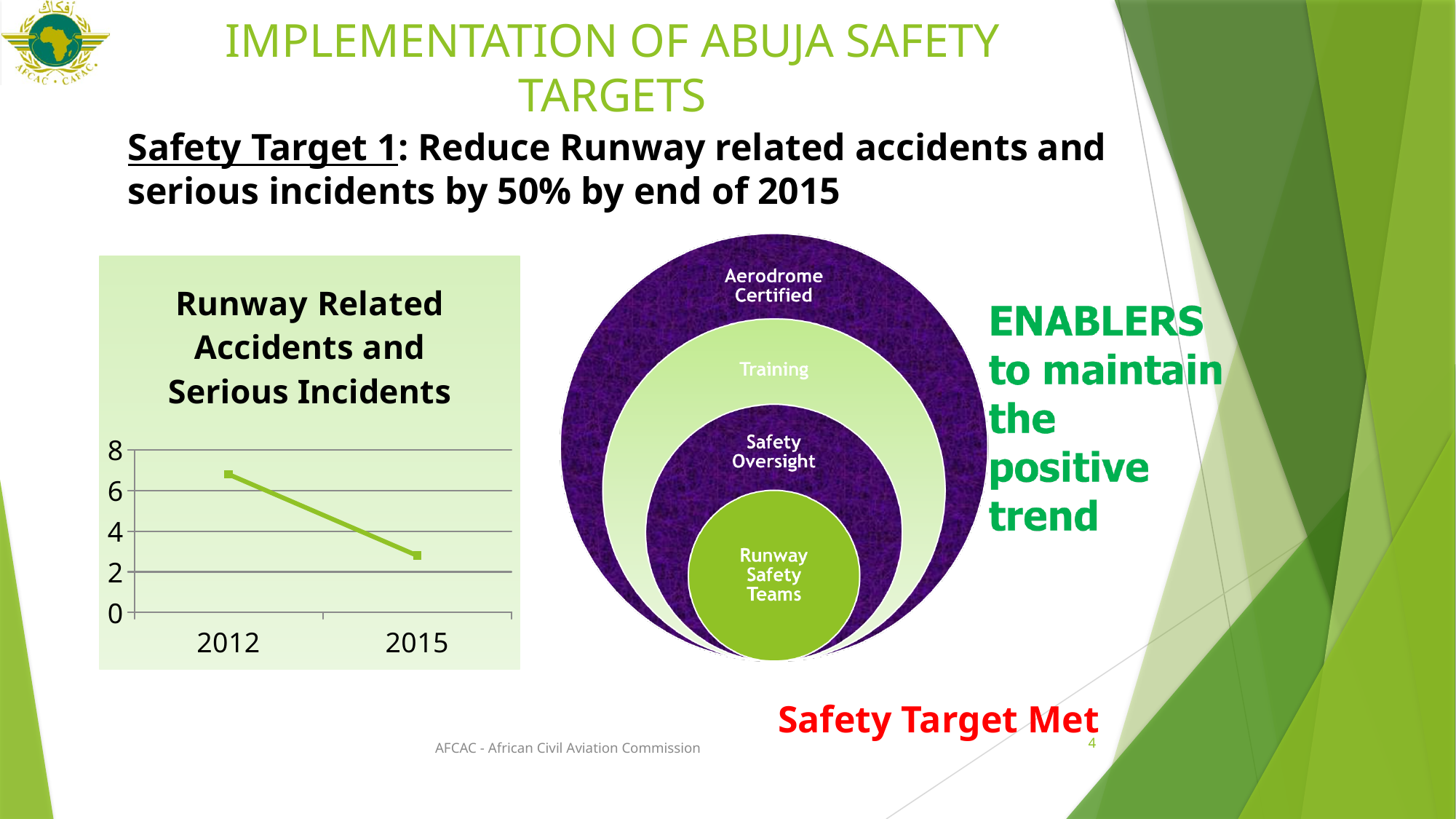
What kind of chart is the 'Runway Related Accidents and Serious Incidents' chart? line chart Which year has the highest value on the 'Runway Related Accidents and Serious Incidents' chart? 2012 On the 'Runway Related Accidents and Serious Incidents' chart, is the value for 2015 greater or less than 2? greater Do the values on the 'Runway Related Accidents and Serious Incidents' chart rise or fall from 2012 to 2015? fall How many data points are plotted on the 'Runway Related Accidents and Serious Incidents' line chart? 2 What is the highest tick value shown on the y axis of the 'Runway Related Accidents and Serious Incidents' chart? 8 On the 'Runway Related Accidents and Serious Incidents' chart, which year has the higher value, 2012 or 2015? 2012 On the 'Runway Related Accidents and Serious Incidents' chart, is the value for 2012 greater or less than 6? greater On the 'Runway Related Accidents and Serious Incidents' chart, is the value for 2015 greater or less than 4? less What is the title of the line chart on the left of the slide? Runway Related Accidents and Serious Incidents Which year has the lowest value on the 'Runway Related Accidents and Serious Incidents' chart? 2015